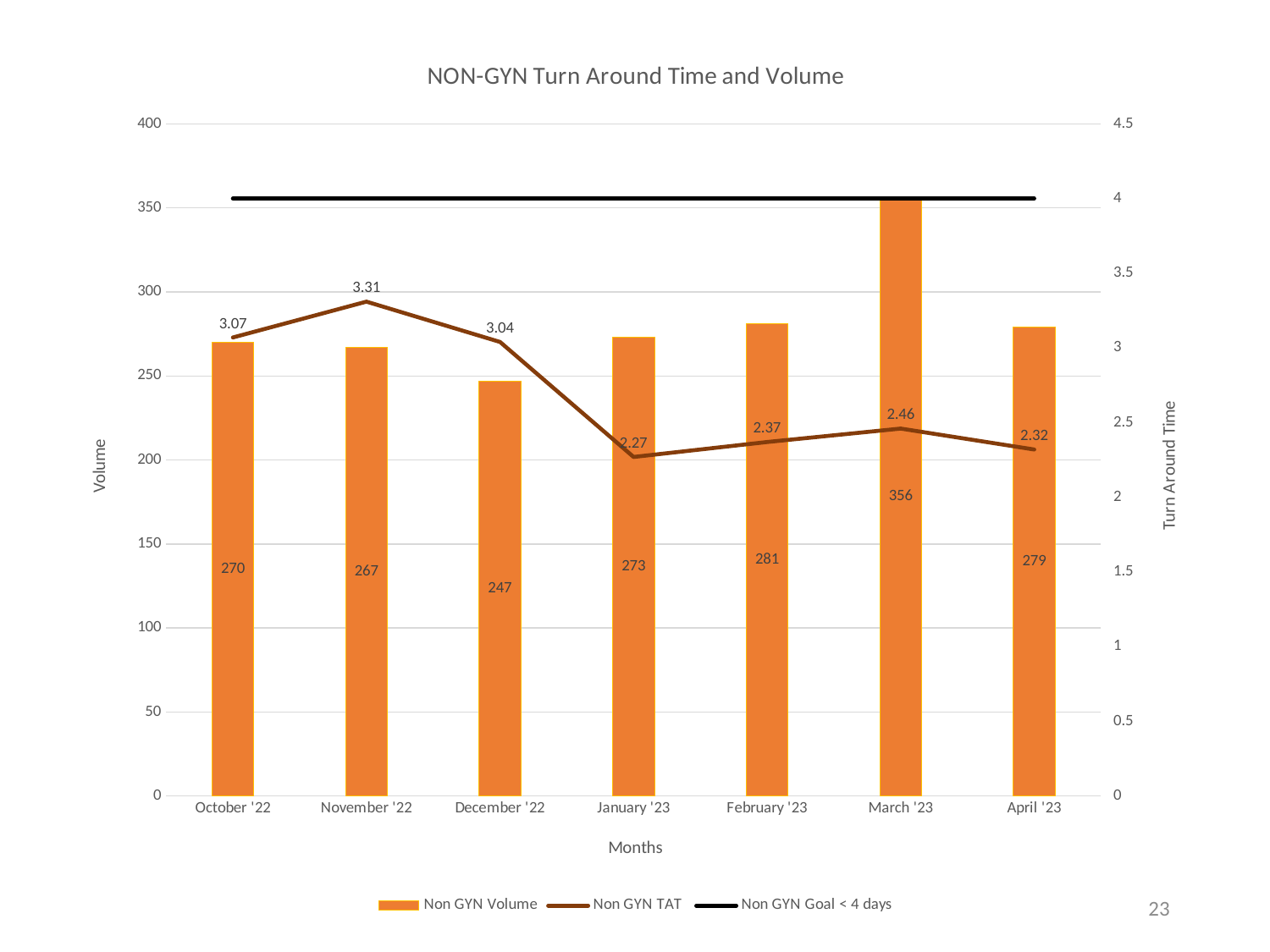
Does the Non GYN TAT rise or fall from November '22 to January '23? fall What is the Non GYN Volume for March '23? 356 Which month has the highest Non GYN Volume? March '23 Which is larger, the Non GYN Volume for October '22 or for November '22? October '22 What is the Non GYN TAT value for November '22? 3.31 Which month has the lowest Non GYN TAT? January '23 What is the difference in Non GYN Volume between March '23 and February '23? 75 Is the Non GYN TAT for April '23 greater or less than 2.5? less How many months are shown on the x axis? 7 What is the Non GYN Volume for December '22? 247 How many series does the legend list? 3 What is the title of the chart? NON-GYN Turn Around Time and Volume